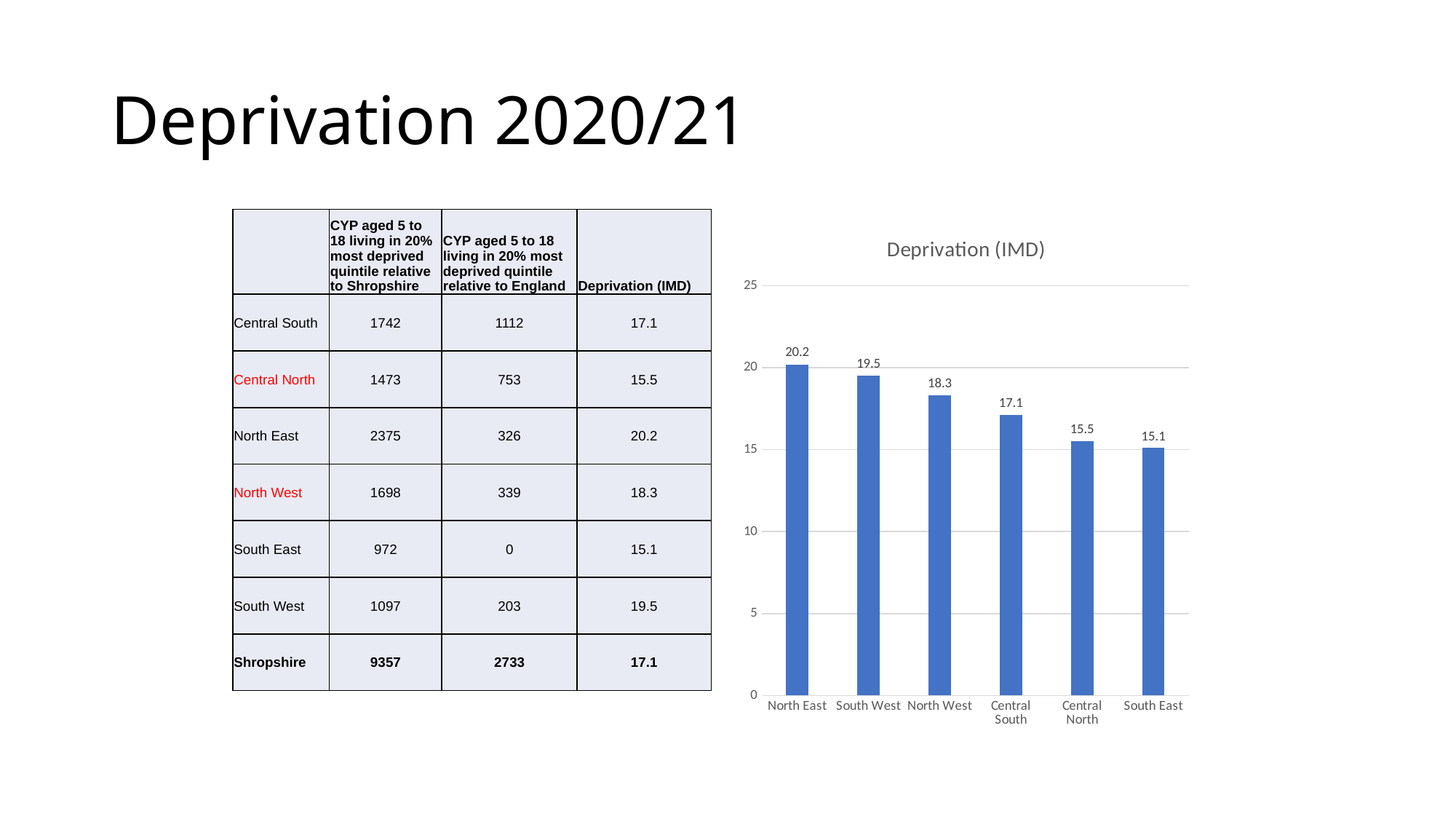
Do the Deprivation (IMD) values rise or fall from left to right across the chart? fall What is the Deprivation (IMD) value for Central North? 15.5 Which area has the highest Deprivation (IMD) value in the chart? North East Which area has the lowest Deprivation (IMD) value in the chart? South East What is the Deprivation (IMD) value for South West? 19.5 What kind of chart is the Deprivation (IMD) chart? bar chart What is the difference between the Deprivation (IMD) values for North East and South East? 5.1 How many areas are shown in the Deprivation (IMD) chart? 6 What is the difference between the Deprivation (IMD) values for North West and Central South? 1.2 Which has a higher Deprivation (IMD) value, North West or Central North? North West Is the Deprivation (IMD) value for Central South greater or less than 15? greater What is the Deprivation (IMD) value for North East? 20.2